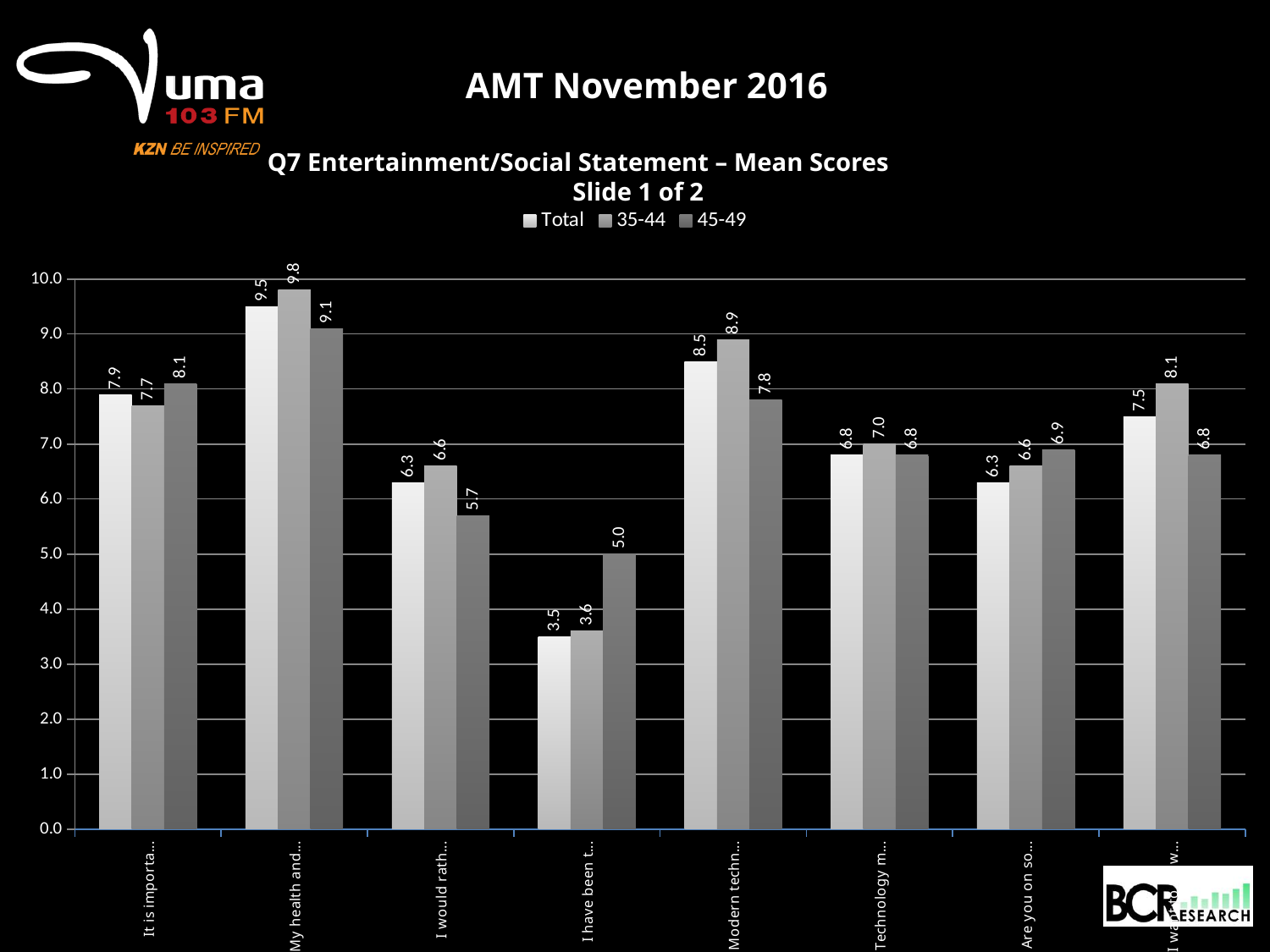
For the category labelled "I would rath...", which is larger: the Total score or the 45-49 score? Total What is the 35-44 mean score for the category labelled "Technology m..."? 7.0 How many series does the legend list? 3 What kind of chart is shown on the slide? bar chart Which category has the highest Total mean score? My health and... Is the Total mean score for the category labelled "Modern techn..." greater or less than 8.0? greater Which category has the lowest 35-44 mean score? I have been t... What is the 45-49 mean score for the category labelled "I have been t..."? 5.0 What is the Total mean score for the category labelled "My health and..."? 9.5 For the category labelled "Modern techn...", what is the difference between the 35-44 score and the 45-49 score? 1.1 How many categories (statements) are plotted along the x axis? 8 What are the three series named in the legend? Total, 35-44, 45-49